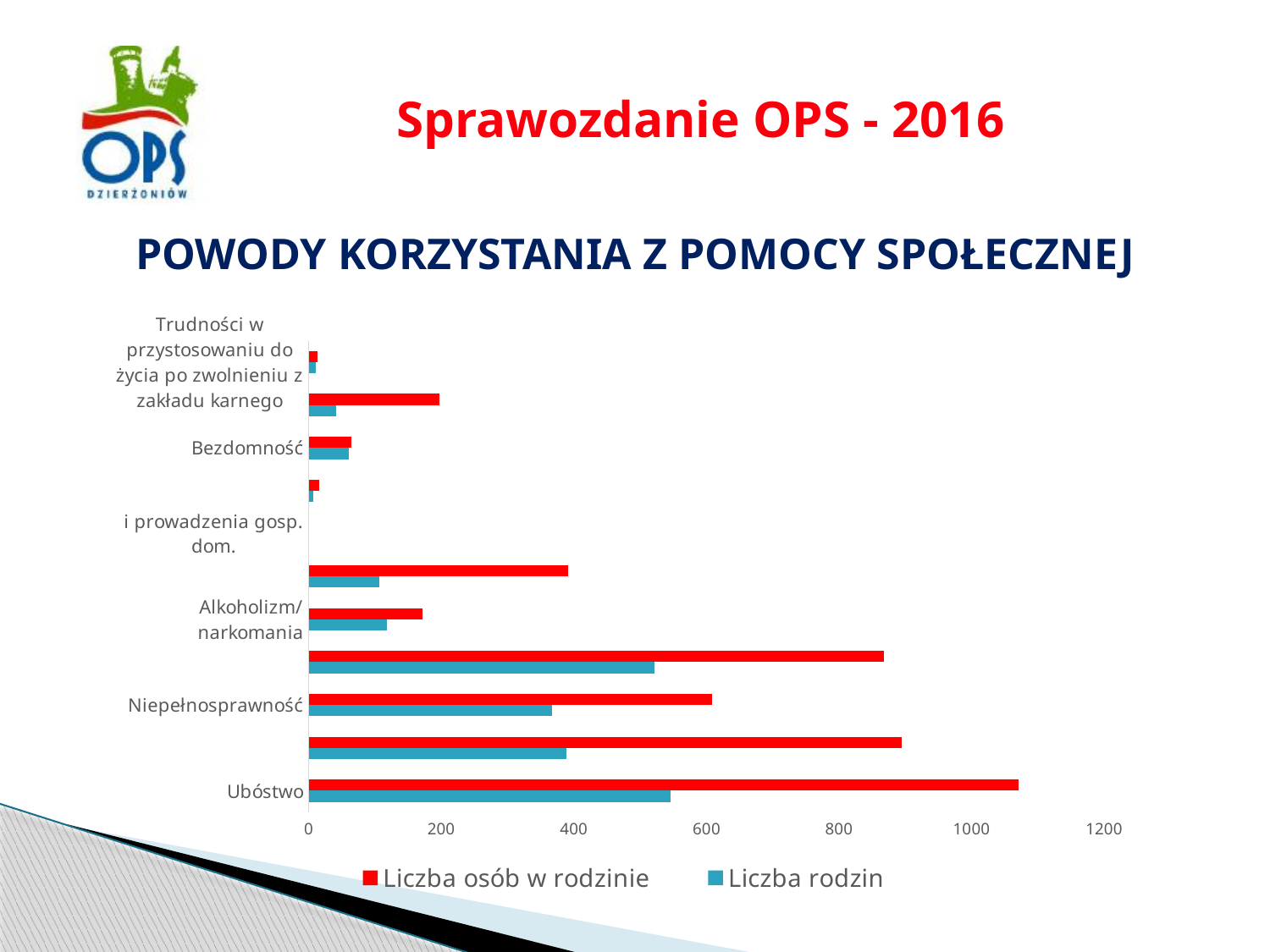
How many series does the legend list? 2 Which category has the highest value for Liczba rodzin? Ubóstwo For Ubóstwo, which series has the larger value: Liczba osób w rodzinie or Liczba rodzin? Liczba osób w rodzinie What kind of chart is shown on the slide? bar chart Is the value of Liczba rodzin for Ubóstwo greater or less than 400? greater What are the two series named in the legend? Liczba osób w rodzinie and Liczba rodzin Which category has the highest value for Liczba osób w rodzinie? Ubóstwo Is the value of Liczba rodzin for Niepełnosprawność greater or less than 400? less Which colour represents the series Liczba rodzin? blue Is the value of Liczba osób w rodzinie for Ubóstwo greater or less than 1000? greater Which is larger for Liczba osób w rodzinie: Ubóstwo or Niepełnosprawność? Ubóstwo